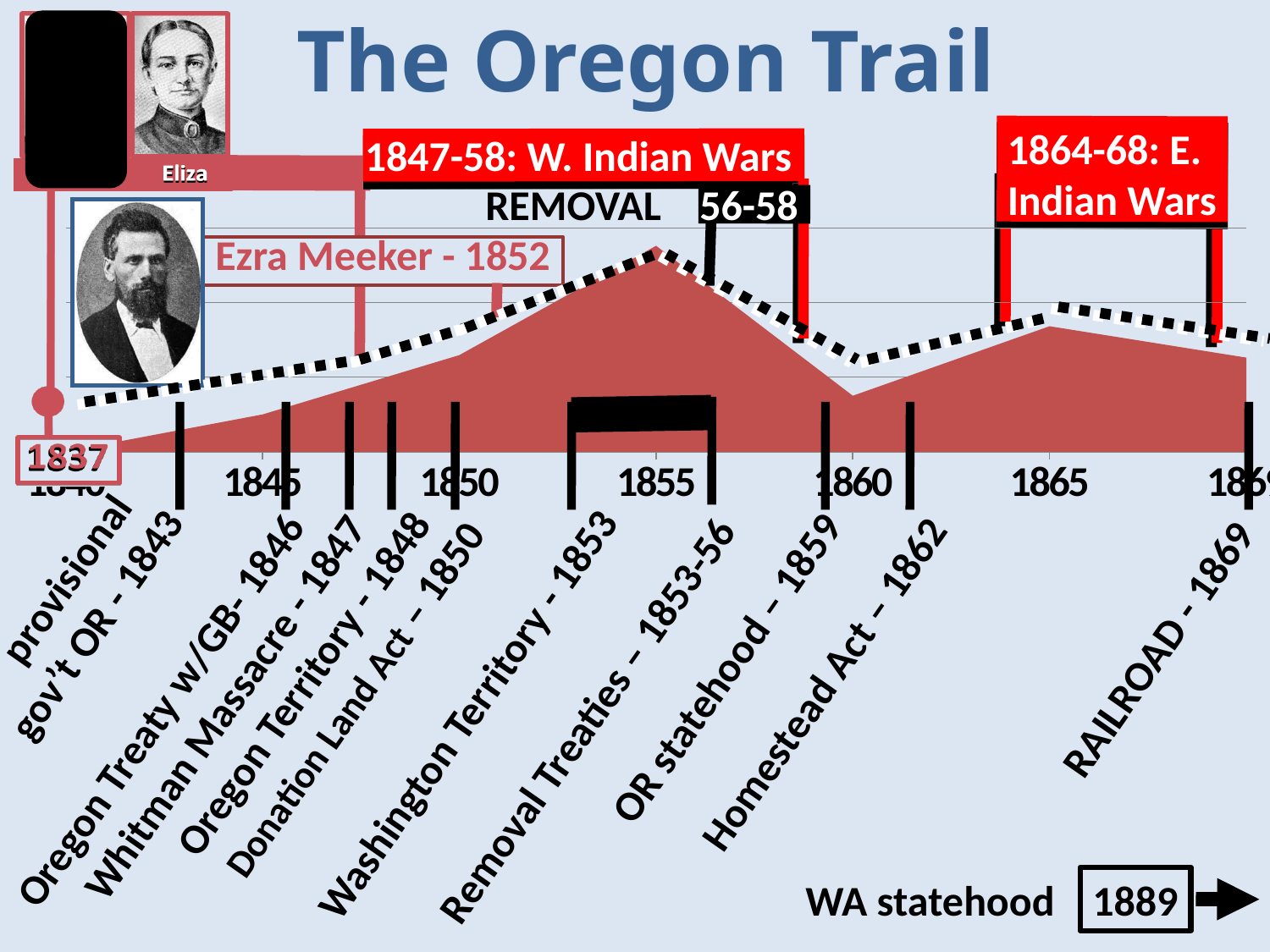
Around which labelled year does the red shaded area reach its highest point? 1855 Is the red shaded area higher at 1850 or at 1845? 1850 Is the red shaded area higher at 1855 or at 1860? 1855 Does the red shaded area rise or fall between 1840 and 1855? rise Does the red shaded area rise or fall between 1865 and 1869? fall What is the title of the slide containing the chart? The Oregon Trail What kind of chart is shown on the slide? area chart Does the red shaded area rise or fall between 1855 and 1860? fall Is the red shaded area higher at 1865 or at 1860? 1865 What colour is the shaded area of the chart? red